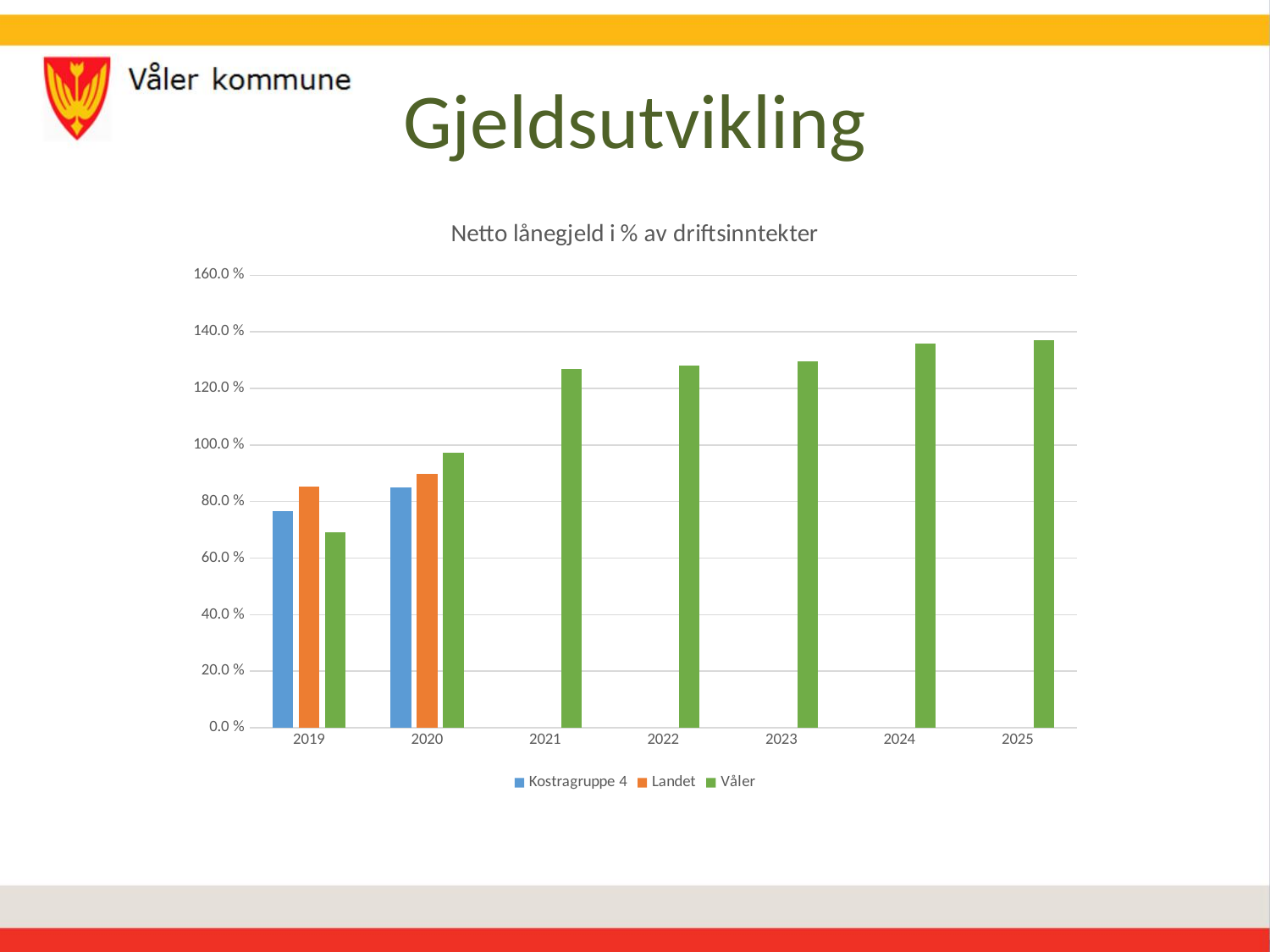
How many series does the legend list? 3 Is the value for Landet in 2019 greater or less than 80.0 %? greater Do the values for Våler rise or fall from 2019 to 2025? rise What is the title of the chart? Netto lånegjeld i % av driftsinntekter Is the value for Våler in 2025 greater or less than 140.0 %? less Which is larger for Våler: the value in 2019 or the value in 2020? 2020 In 2020, which series has the lowest value? Kostragruppe 4 How many years are shown on the x axis? 7 What type of chart is shown on the slide? bar chart Is the value for Våler in 2021 greater or less than 120.0 %? greater In 2019, which series has the highest value? Landet